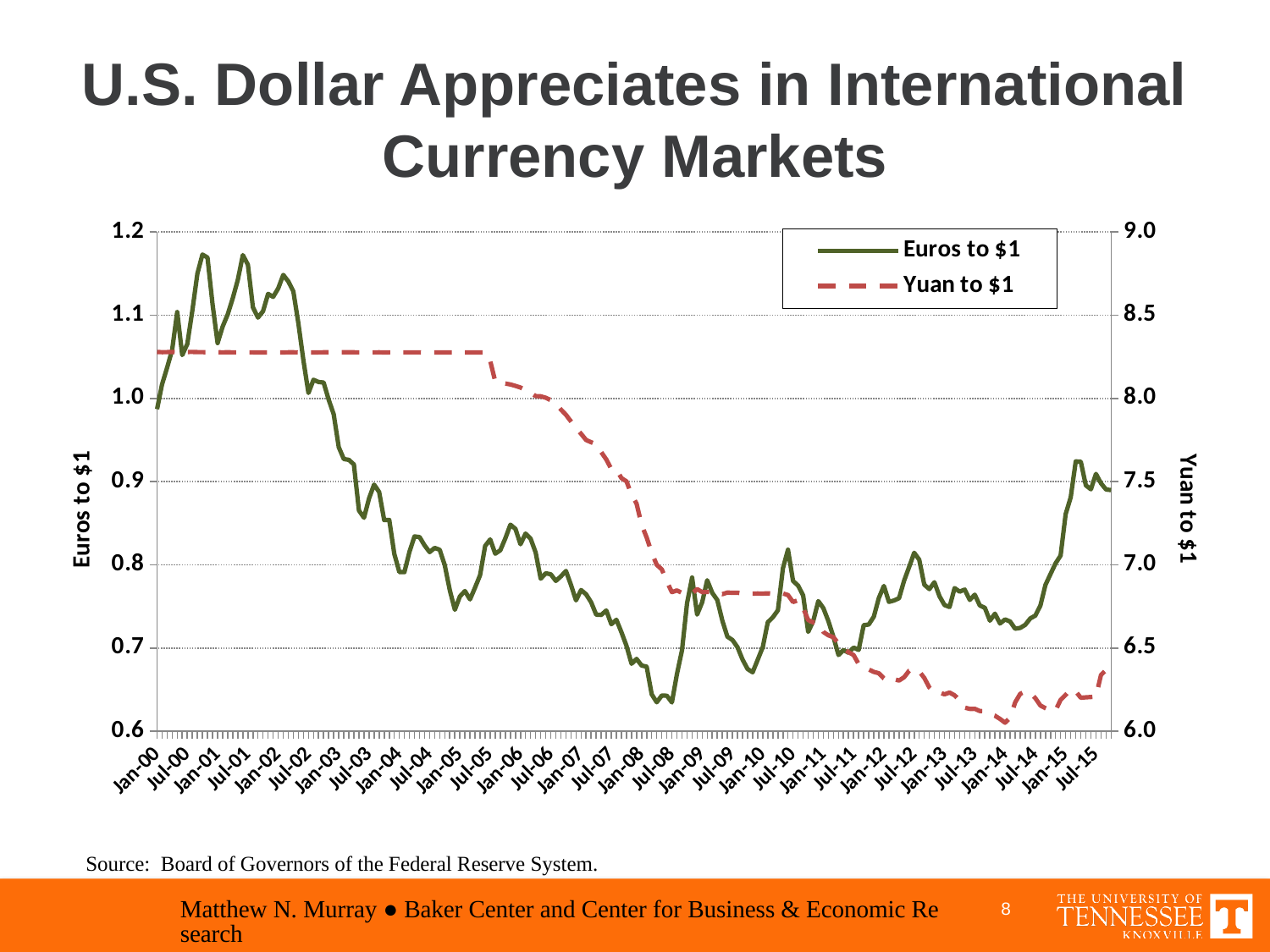
Which series is drawn with a dashed line? Yuan to $1 Does the Yuan to $1 series rise or fall overall from Jan-00 to Jul-15? fall Does the Euros to $1 series rise or fall overall from Jan-02 to Jul-08? fall Is the value of Yuan to $1 at Jul-08 greater or less than 7.0? less Is the value of Euros to $1 at Jul-01 greater or less than 1.1? greater Is the value of Yuan to $1 at Jan-14 greater or less than 6.5? less What kind of chart is shown on the slide? line chart What is the title of the slide's chart? U.S. Dollar Appreciates in International Currency Markets How many series does the legend list? 2 Does the Euros to $1 series rise or fall from Jul-14 to Jan-15? rise